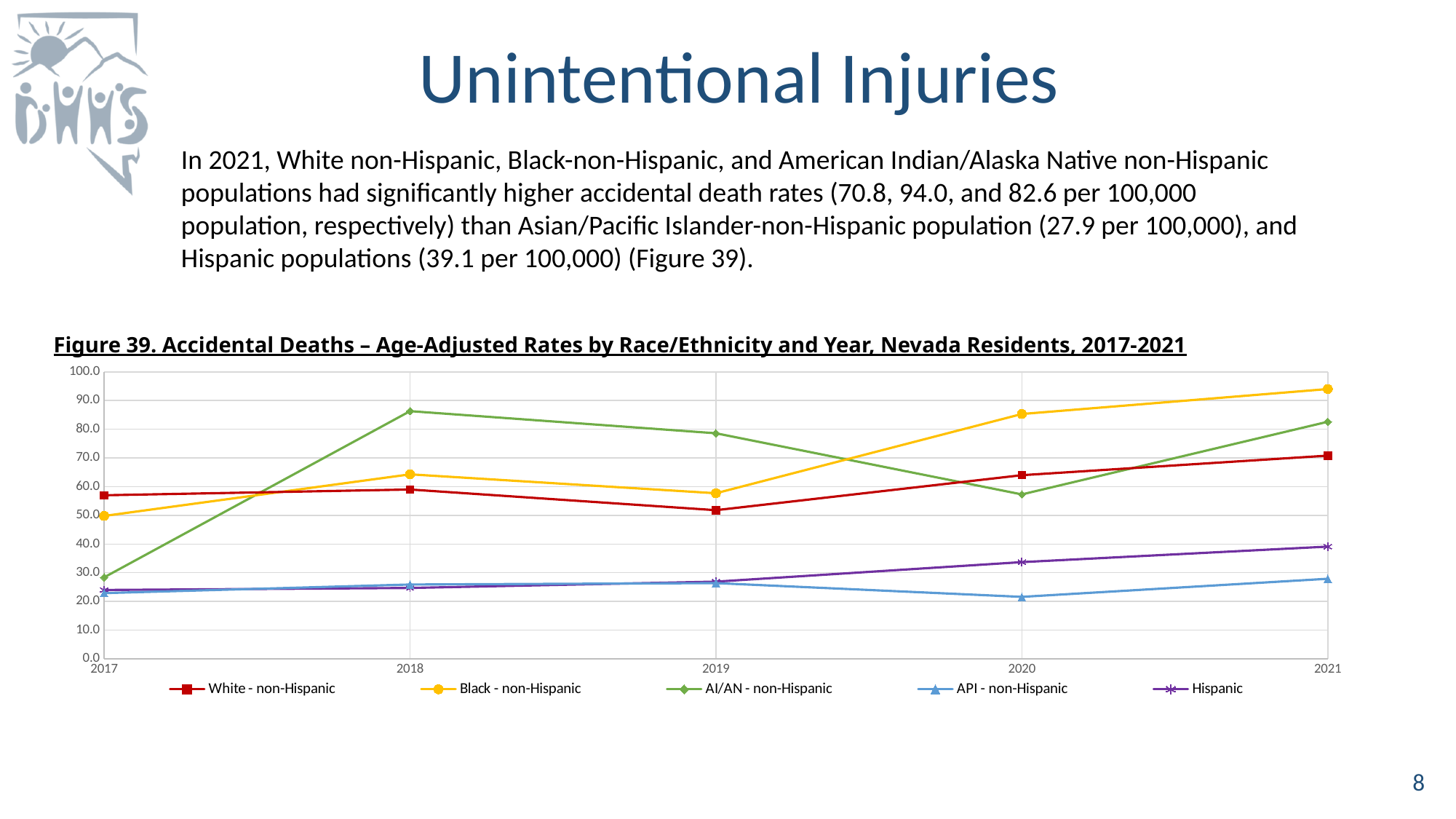
In Figure 39, is the value for Black - non-Hispanic in 2020 greater or less than 80.0? greater In Figure 39, which race/ethnicity group has the lowest rate in 2021? API - non-Hispanic In Figure 39, does the Hispanic rate rise or fall from 2017 to 2021? rise In Figure 39, which is higher in 2019: White - non-Hispanic or Black - non-Hispanic? Black - non-Hispanic According to the slide, what was the 2021 accidental death rate for the Black non-Hispanic population per 100,000? 94.0 In Figure 39, which race/ethnicity group has the lowest rate in 2020? API - non-Hispanic What kind of chart is Figure 39? line chart In Figure 39, which race/ethnicity group has the highest rate in 2018? AI/AN - non-Hispanic How many series does the legend of Figure 39 list? 5 How many years are shown on the x axis of Figure 39? 5 In Figure 39, which race/ethnicity group has the highest rate in 2021? Black - non-Hispanic In Figure 39, is the value for AI/AN - non-Hispanic in 2017 greater or less than 40.0? less